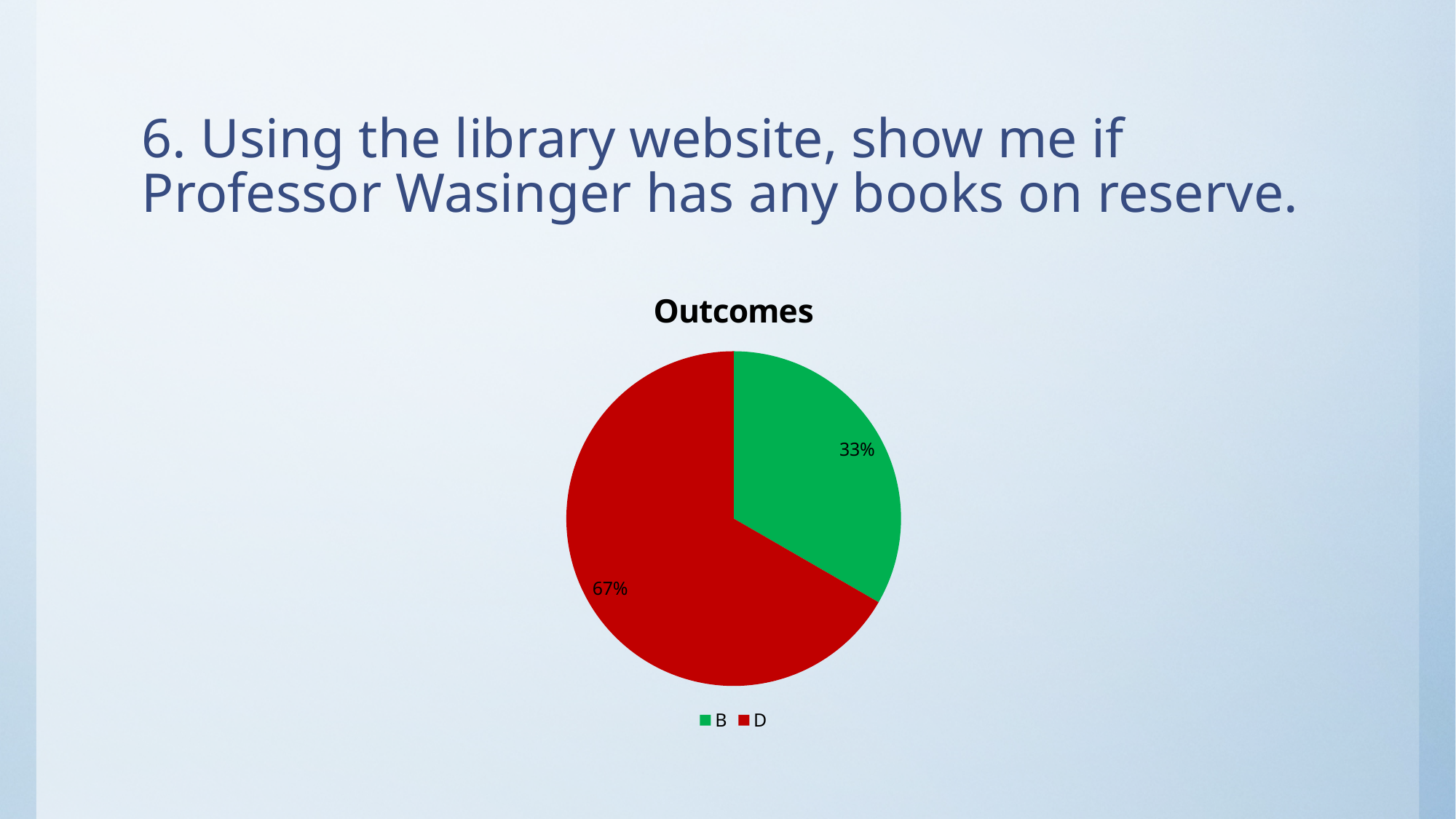
Which category has the smallest slice of the pie? B What kind of chart is shown on the slide? pie chart How many slices does the pie chart have? 2 Which category has the largest slice of the pie? D How many entries does the legend list? 2 What is the title of the chart? Outcomes What share of the pie does category D have? 67% What share of the pie does category B have? 33% What colour is the slice for category D? red What is the difference in percentage points between the D slice and the B slice? 34 Which is larger, the slice for B or the slice for D? D